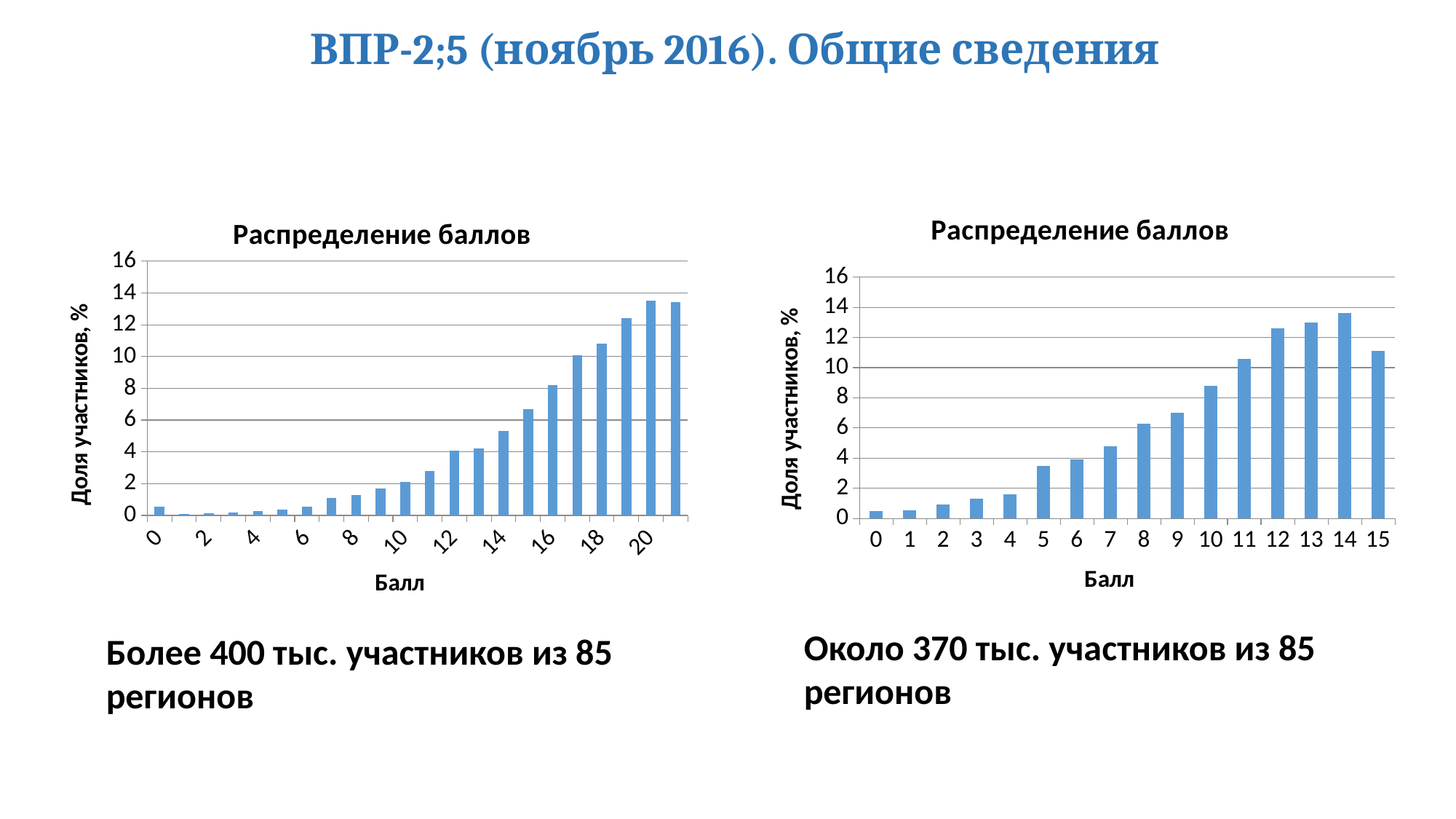
In the chart on the right, do the values generally rise or fall as the score increases from 0 to 14? rise In the chart on the left, is the value for score 18 greater or less than 10? greater In the chart on the left, is the value for score 14 greater or less than 6? less What is the label of the vertical axis of the chart on the left? Доля участников, % In the chart on the right, which score has a larger share of participants, 14 or 15? 14 In the chart on the left, which score (Балл) has the lowest share of participants? 1 In the chart on the right, which score (Балл) has the highest share of participants? 14 How many bars are plotted in the chart on the right? 16 What kind of chart is the chart on the left of the slide? bar chart In the chart on the left, which score has a larger share of participants, 18 or 19? 19 In the chart on the right, is the value for score 5 greater or less than 4? less